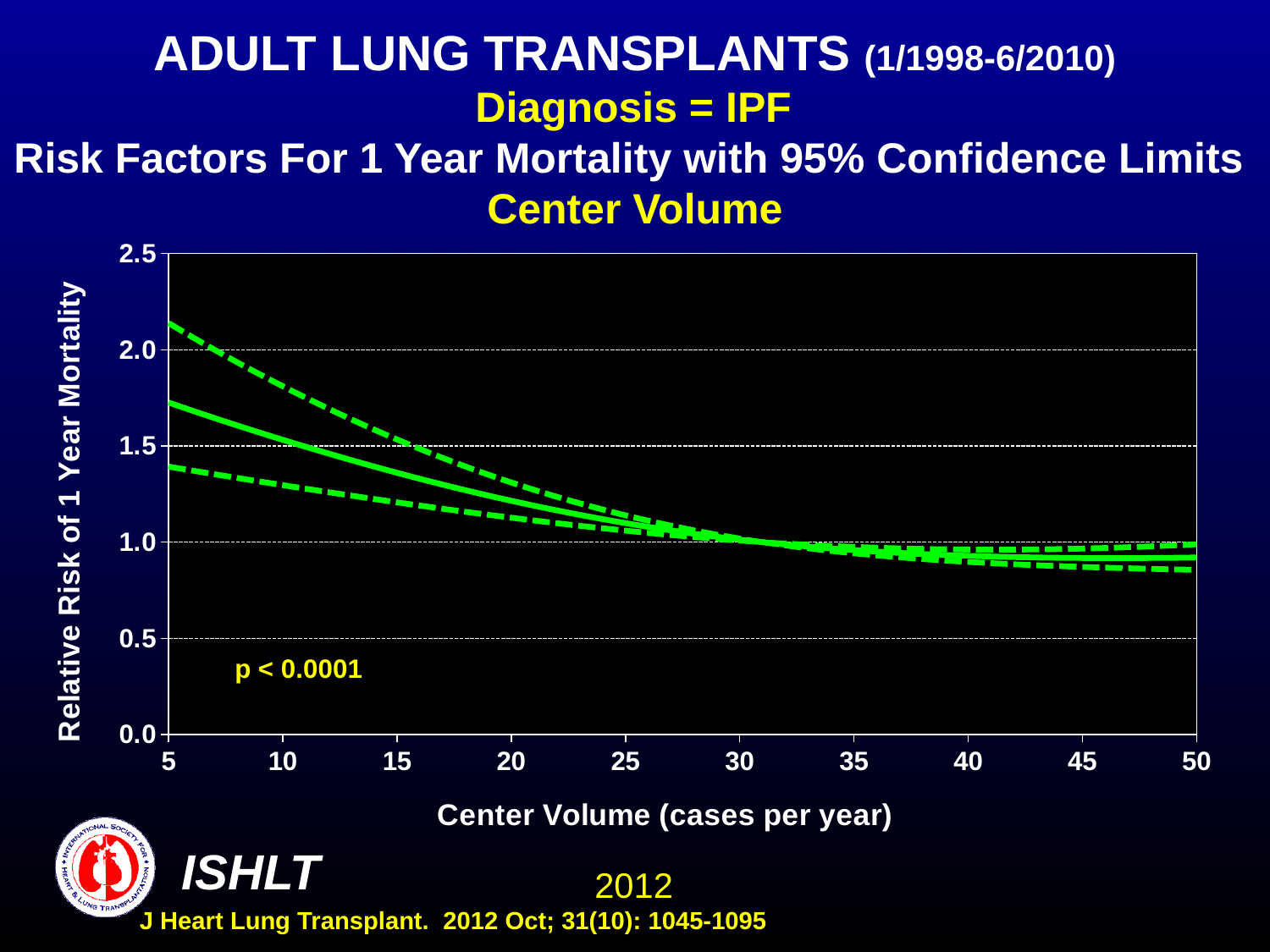
Is the upper dashed confidence limit at a center volume of 5 cases per year greater or less than 2.0? greater Is the relative risk on the solid line at a center volume of 5 cases per year greater or less than 1.5? greater Which has the higher relative risk on the solid line: a center volume of 5 or a center volume of 50 cases per year? 5 What is the label of the x axis? Center Volume (cases per year) What p-value is printed on the chart? p < 0.0001 How many curves are plotted on the chart? 3 As center volume increases from 5 to 50 cases per year, does the relative risk of 1 year mortality rise or fall? fall What kind of chart is shown on the slide? line chart Is the relative risk on the solid line at a center volume of 20 cases per year greater or less than 1.0? greater